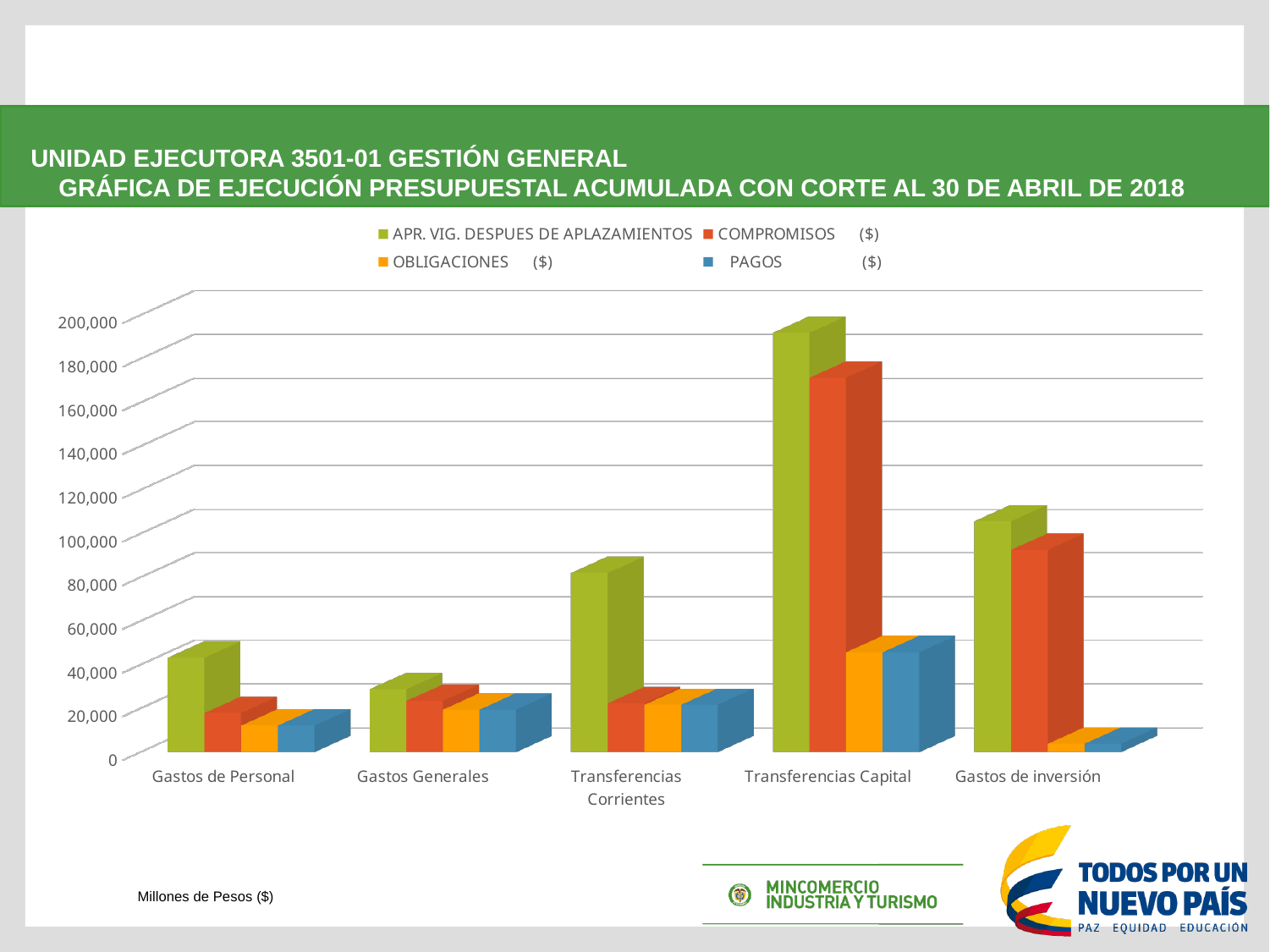
Which category has the lowest APR. VIG. DESPUES DE APLAZAMIENTOS value? Gastos Generales Which category has the highest APR. VIG. DESPUES DE APLAZAMIENTOS value? Transferencias Capital Which series is shown in green in the chart's legend? APR. VIG. DESPUES DE APLAZAMIENTOS What kind of chart is shown on the slide? Bar chart Is the PAGOS value for Gastos de inversión greater or less than 20,000? less How many categories are shown on the x axis of the chart? 5 Which category has the highest COMPROMISOS value? Transferencias Capital How many series does the chart's legend list? 4 Is the COMPROMISOS value for Gastos de inversión greater or less than 60,000? greater Which is larger: the APR. VIG. DESPUES DE APLAZAMIENTOS value for Transferencias Corrientes or for Gastos de inversión? Gastos de inversión Is the APR. VIG. DESPUES DE APLAZAMIENTOS value for Transferencias Capital greater or less than 160,000? greater